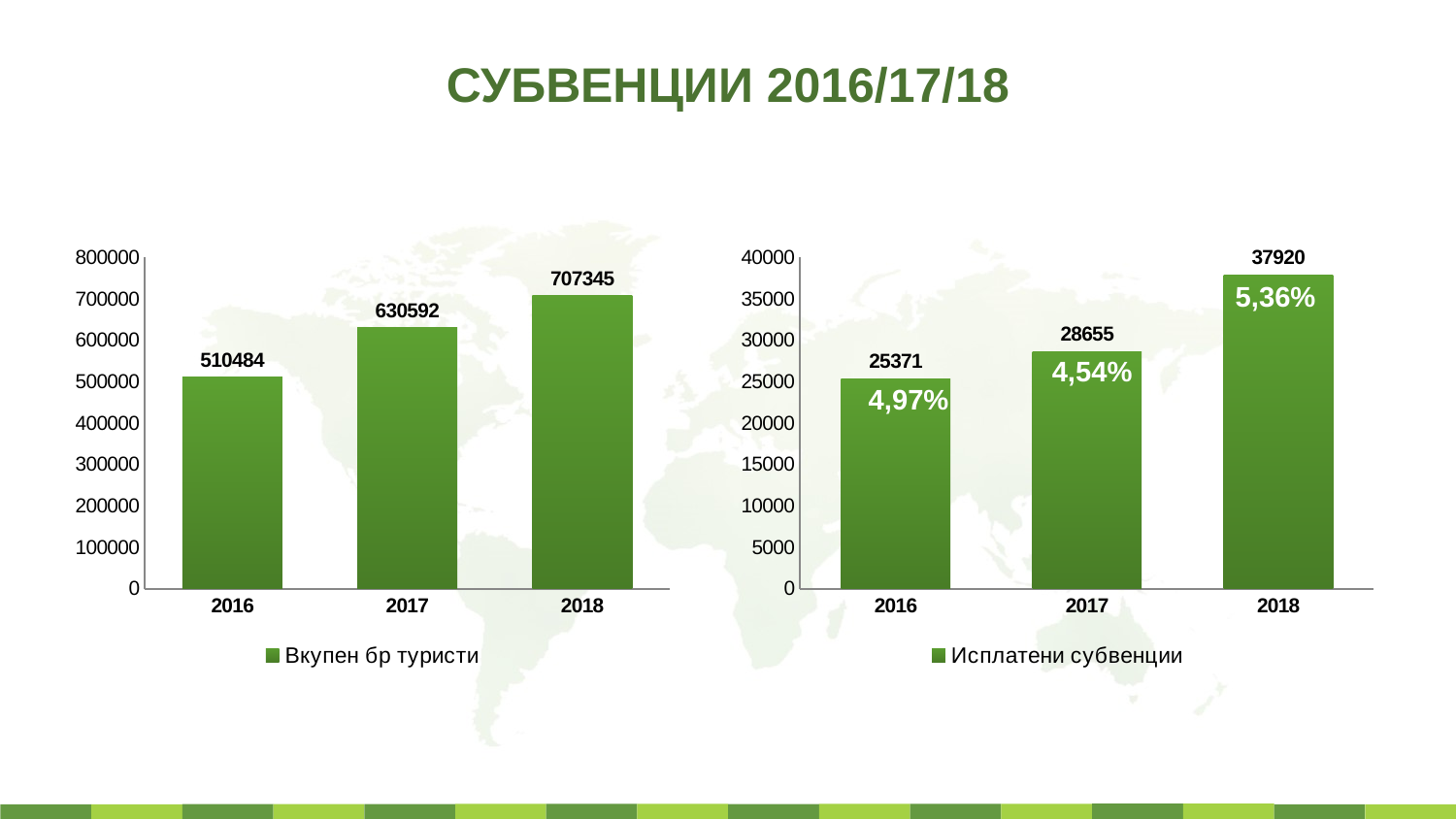
In the right chart, which year has the lowest value? 2016 In the left chart, what is the difference between the values for 2017 and 2016? 120108 In the left chart, do the values rise or fall from 2016 to 2018? rise In the left chart, is the value for 2018 greater or less than 700000? greater What kind of chart is the right chart? bar chart In the left chart, which year has the highest value? 2018 In the right chart, what percentage is printed on the 2016 bar? 4,97% In the right chart, what is the difference between the values for 2018 and 2017? 9265 How many years are shown on the x axis of the left chart? 3 In the right chart, which is larger, the value for 2017 or the value for 2016? 2017 In the left chart, what is the value for 2017? 630592 In the right chart, what is the value for 2018? 37920